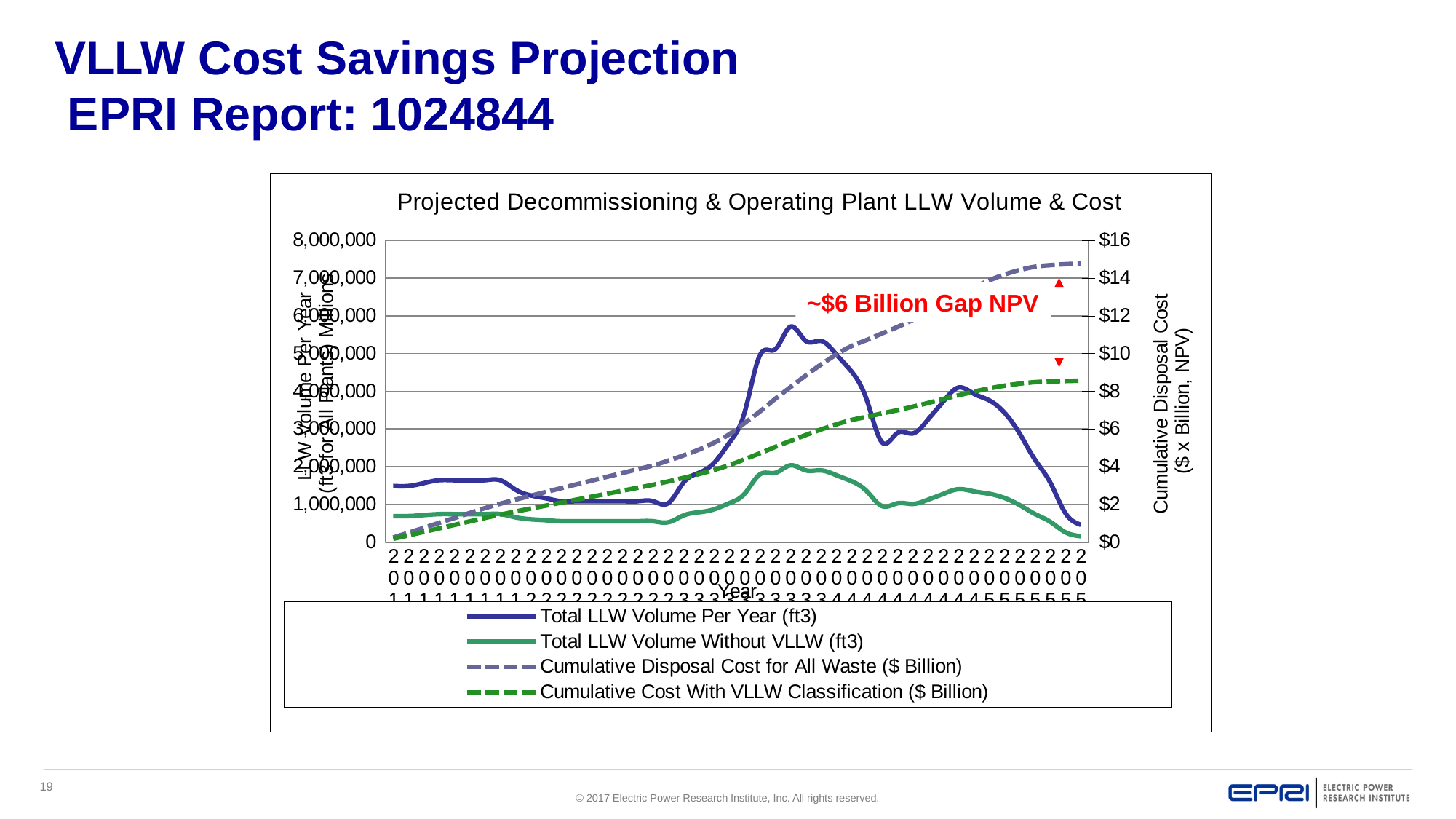
What gap is called out by the red annotation on the chart? ~$6 Billion Gap NPV Is the peak value of Total LLW Volume Per Year (ft3) greater or less than 5,000,000? greater Which series reaches a higher peak: Total LLW Volume Per Year (ft3) or Total LLW Volume Without VLLW (ft3)? Total LLW Volume Per Year (ft3) Does the Cumulative Cost With VLLW Classification series rise or fall along the x axis? rise At the right end of the chart, is the value of Cumulative Disposal Cost for All Waste greater or less than $14? greater Does the Cumulative Disposal Cost for All Waste series rise or fall along the x axis? rise At the right end of the chart, which is larger: Cumulative Disposal Cost for All Waste or Cumulative Cost With VLLW Classification? Cumulative Disposal Cost for All Waste How many series does the chart's legend list? 4 What kind of chart is shown on the slide? line chart What is the title of the chart? Projected Decommissioning & Operating Plant LLW Volume & Cost Is the peak value of Total LLW Volume Without VLLW (ft3) greater or less than 3,000,000? less